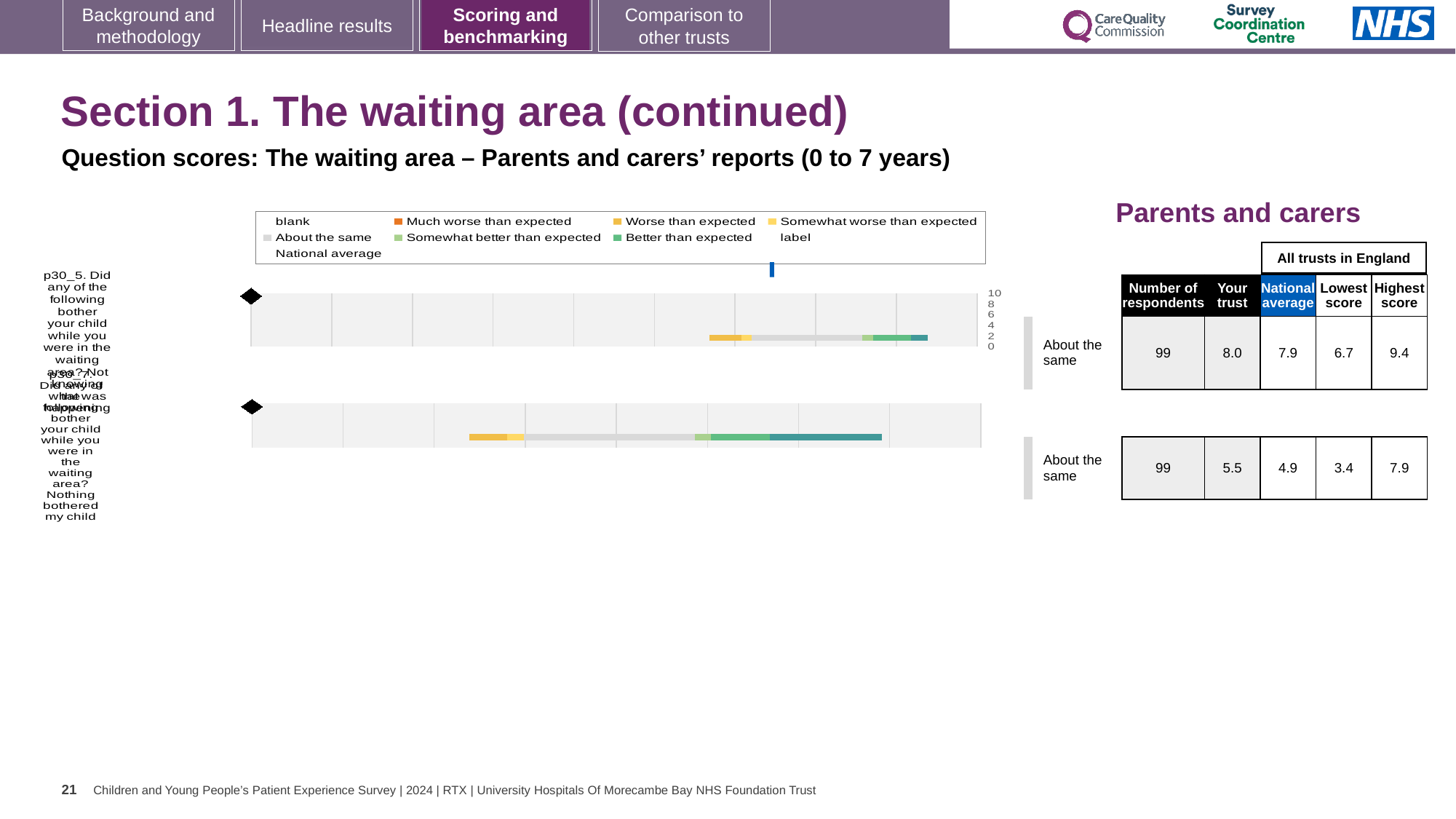
For the top chart, which is larger: the 'Your trust' score or the national average? Your trust What benchmark category is shown beside the bottom chart? About the same For the bottom chart, what is the difference between the highest score (7.9) and the lowest score (3.4)? 4.5 What kind of chart is used to show the question scores on this slide? bar chart How many entries does the legend above the charts list? 9 How many question bars are plotted on the slide? 2 In the table next to the top chart, what is the national average score? 7.9 In the table next to the bottom chart, what is the 'Your trust' score? 5.5 What heading appears above the table to the right of the charts? Parents and carers How many respondents are listed for the top chart's question? 99 In the table next to the bottom chart, what is the lowest score among all trusts in England? 3.4 In the table next to the top chart, what is the 'Your trust' score? 8.0